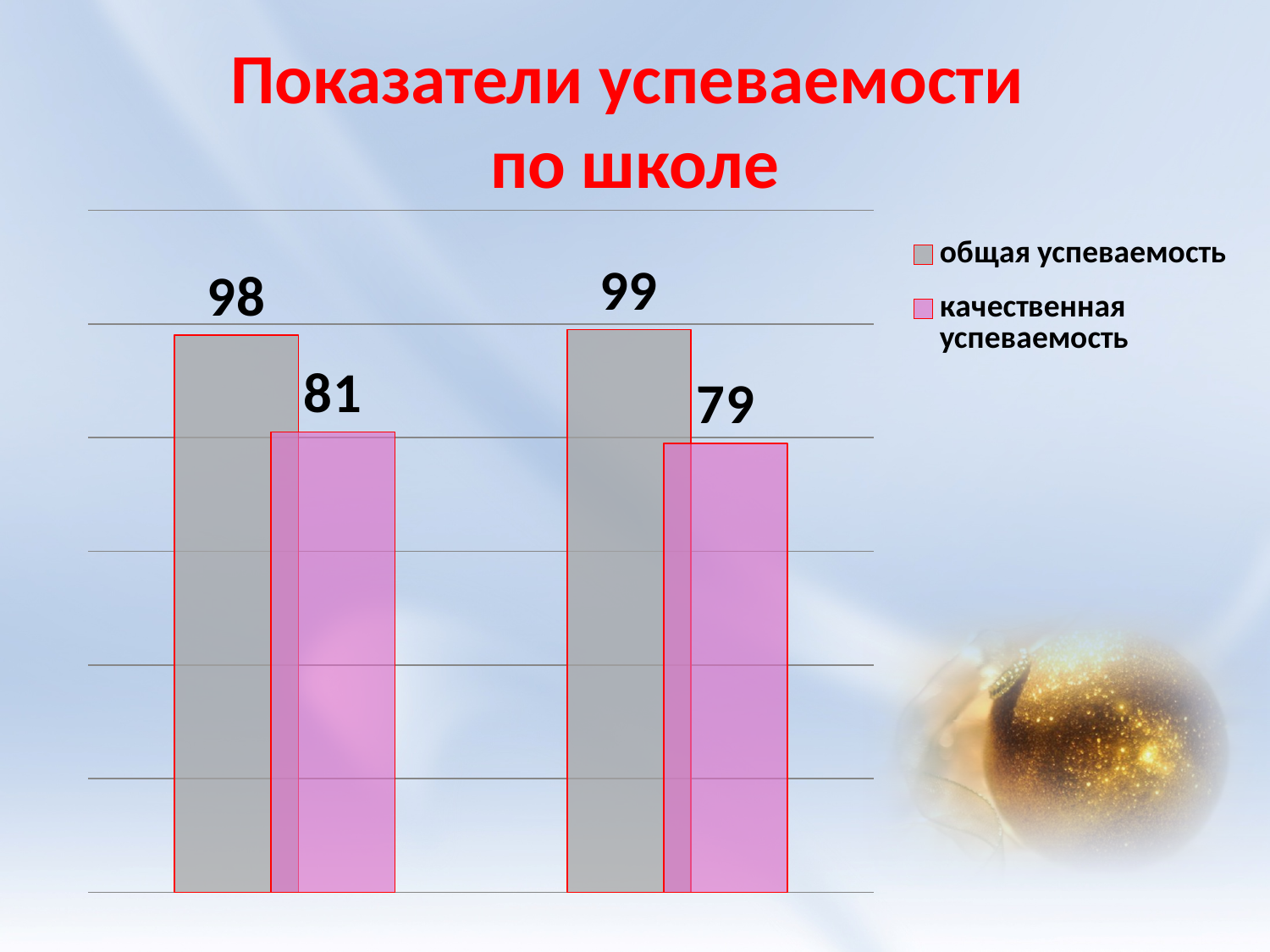
What is the title of the slide? Показатели успеваемости по школе How many series does the legend list? 2 Which bar has the highest value on the chart? общая успеваемость in the right group (99) What is the value of the pink "качественная успеваемость" bar in the left group? 81 What is the value of the grey "общая успеваемость" bar in the left group? 98 What is the value of the "качественная успеваемость" bar in the right group? 79 What is the value of the "общая успеваемость" bar in the right group? 99 Which bar has the lowest value on the chart? качественная успеваемость in the right group (79) What is the difference between "общая успеваемость" and "качественная успеваемость" in the left group? 17 What kind of chart is shown on the slide? bar chart What is the difference between "общая успеваемость" and "качественная успеваемость" in the right group? 20 Which is larger: "качественная успеваемость" in the left group or in the right group? left group (81)